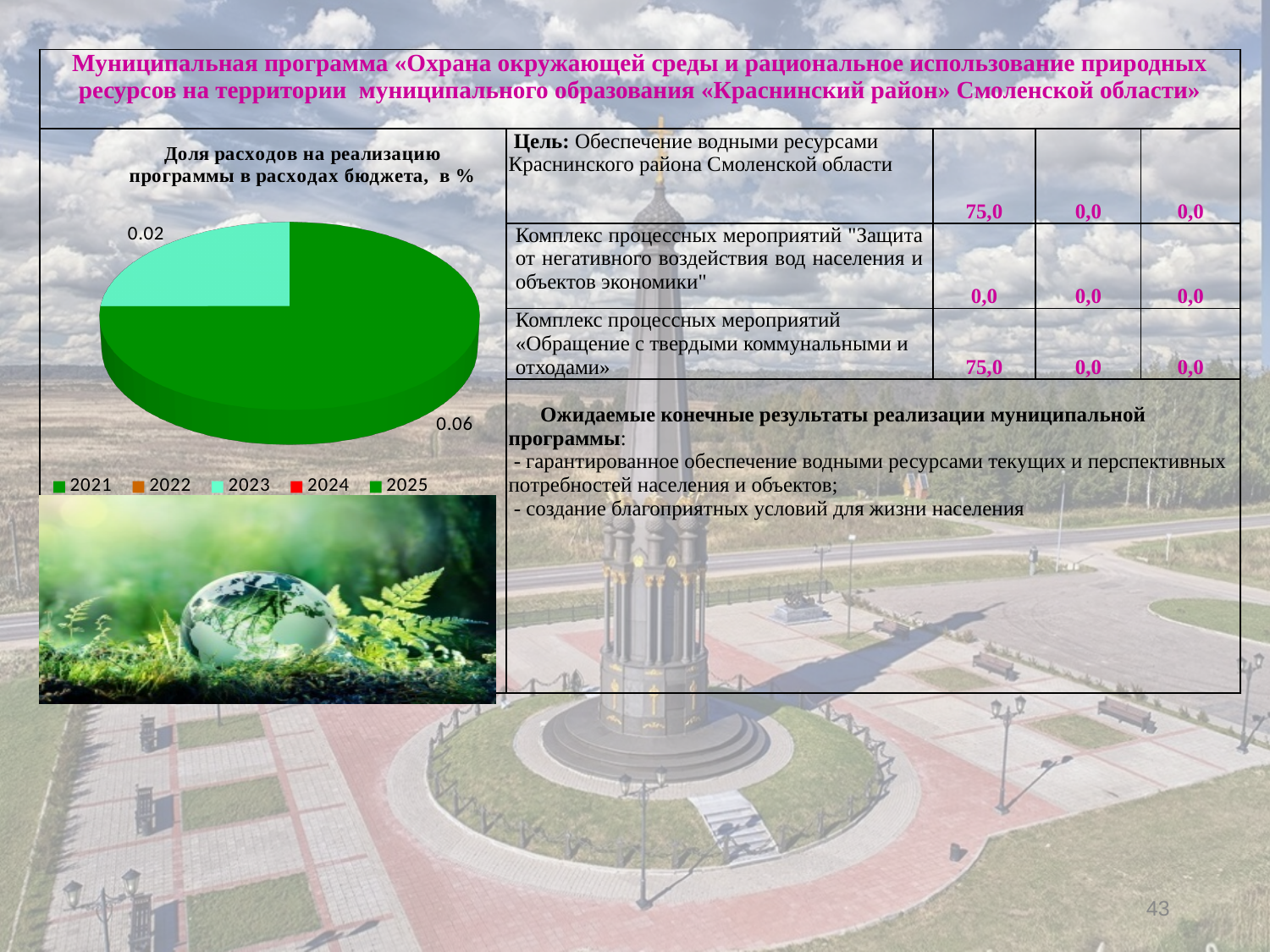
What is the value of the smallest labelled slice of the pie chart? 0.02 How many slices in the pie chart have a data label? 2 What is the difference between the two labelled slice values in the pie chart (0.06 and 0.02)? 0.04 What value is shown for the 2023 slice (light cyan) of the pie chart? 0.02 Which is larger in the pie chart: the green slice or the light cyan (2023) slice? The green slice What kind of chart is shown on the slide? Pie chart What is the total of the two labelled slice values in the pie chart? 0.08 How many entries does the legend of the pie chart list? 5 What is the value of the largest slice of the pie chart? 0.06 What is the title of the pie chart? Доля расходов на реализацию программы в расходах бюджета, в % Which years are listed in the legend of the pie chart? 2021, 2022, 2023, 2024, 2025 What share of the labelled pie total does the 2023 slice (0.02) represent? 25%